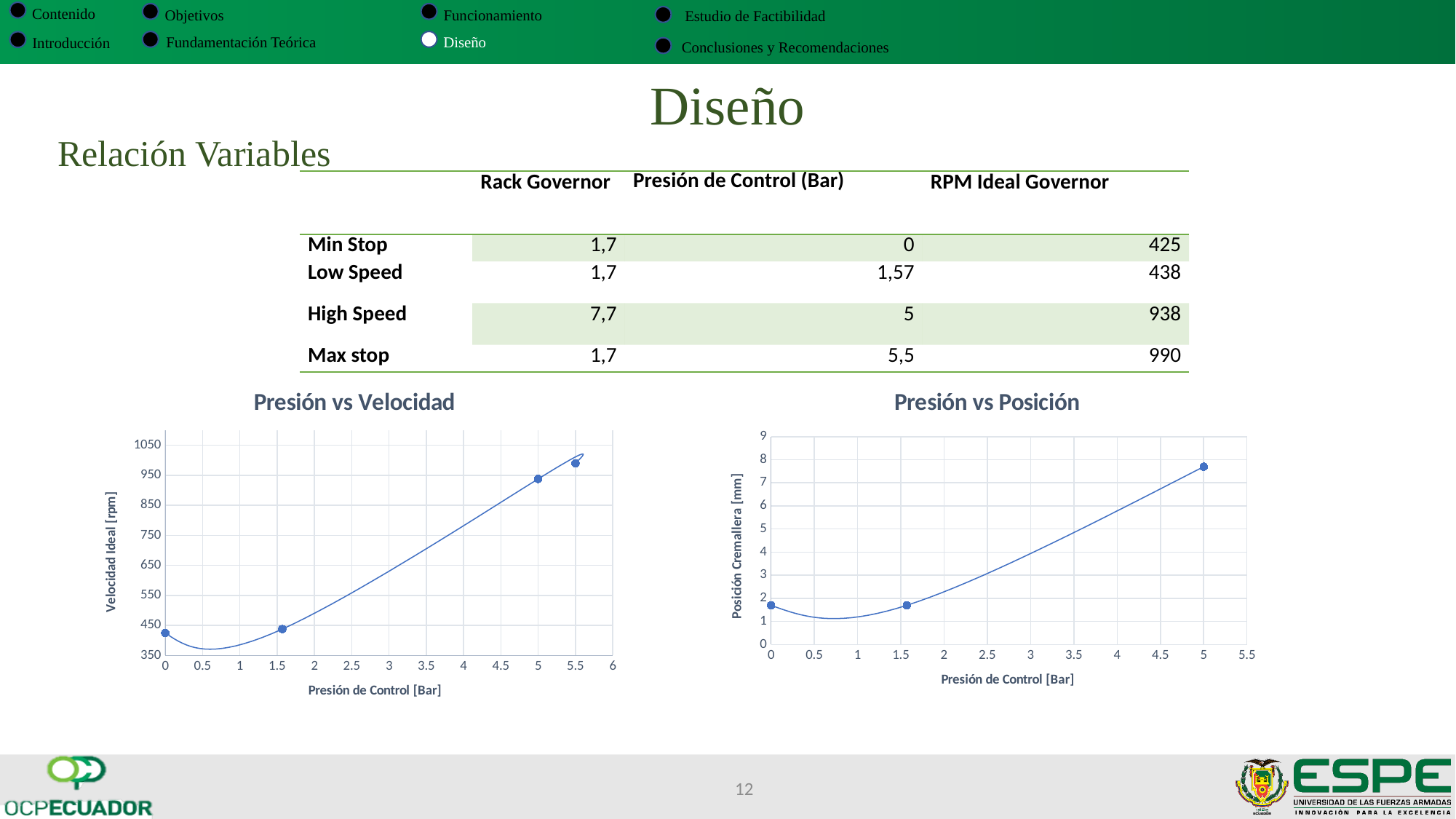
In the "Presión vs Velocidad" chart, which is larger: the velocity at 5 bar or the velocity at 1.5 bar? 5 bar In the "Presión vs Posición" chart, at which control pressure is the rack position highest? 5 bar In the "Presión vs Velocidad" chart, is the velocity at a control pressure of 0 bar greater or less than 450 rpm? less In the "Presión vs Posición" chart, is the rack position at a control pressure of 0 bar greater or less than 2 mm? less What kind of chart is "Presión vs Velocidad"? scatter chart with a smooth line In the "Presión vs Velocidad" chart, how many data points are plotted? 4 In the "Presión vs Posición" chart, is the rack position at a control pressure of 5 bar greater or less than 7 mm? greater In the "Presión vs Posición" chart, how many data points are plotted? 3 In the "Presión vs Velocidad" chart, does the velocity overall rise or fall as control pressure increases? rise In the "Presión vs Velocidad" chart, at which control pressure is the velocity highest? 5.5 bar What is the y-axis label of the "Presión vs Posición" chart? Posición Cremallera [mm]